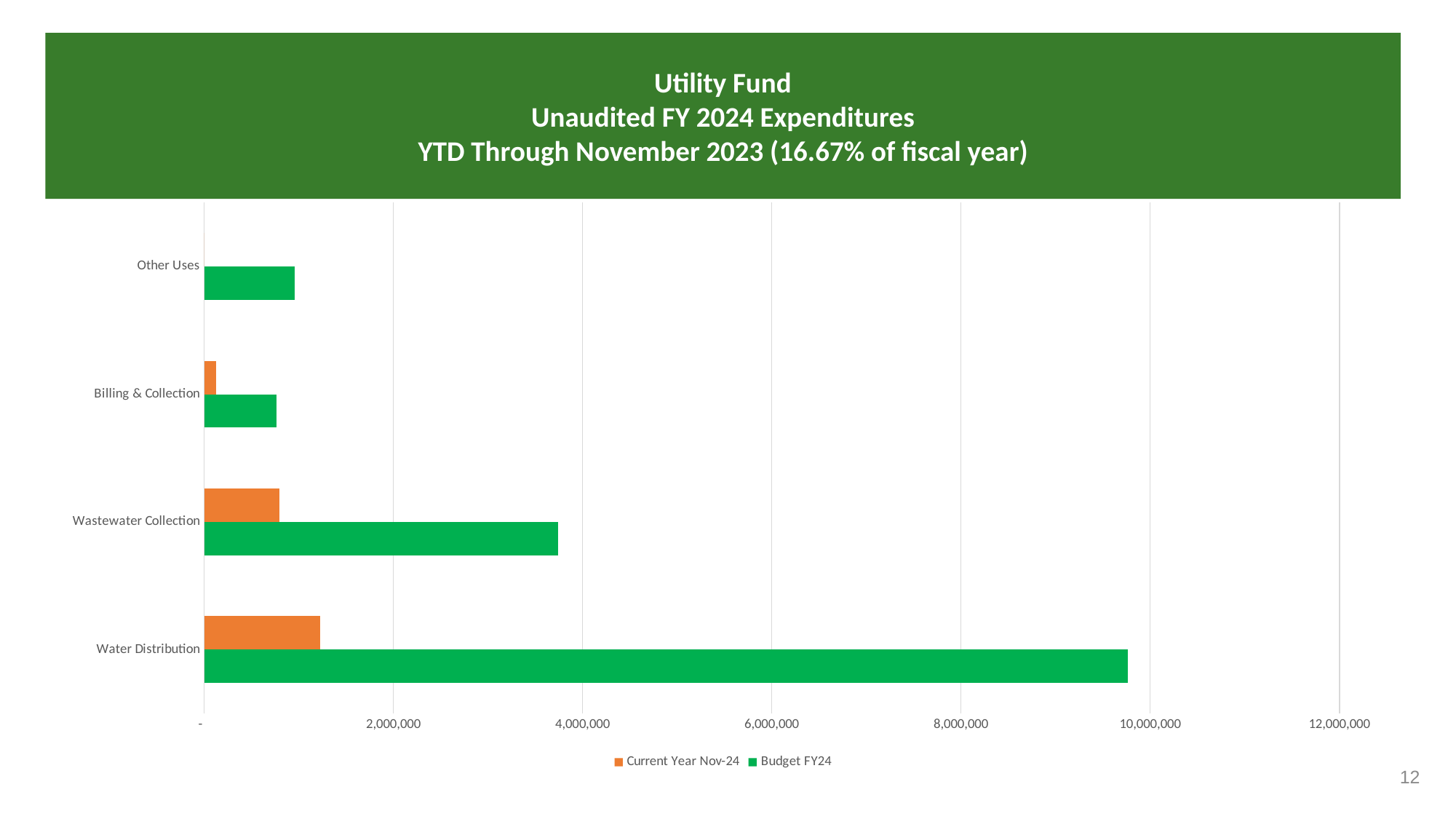
Which category has the highest Budget FY24 value? Water Distribution Which category has the lowest Current Year Nov-24 value? Other Uses Which is larger: the Current Year Nov-24 value for Wastewater Collection or for Billing & Collection? Wastewater Collection How many categories are shown on the chart? 4 Is the Budget FY24 value for Wastewater Collection greater or less than 2,000,000? greater What colour are the Budget FY24 bars? Green Which category has the highest Current Year Nov-24 value? Water Distribution Is the Budget FY24 value for Other Uses greater or less than 2,000,000? less What kind of chart is shown on the slide? Bar chart Is the Current Year Nov-24 value for Water Distribution greater or less than 2,000,000? less How many series does the legend list? 2